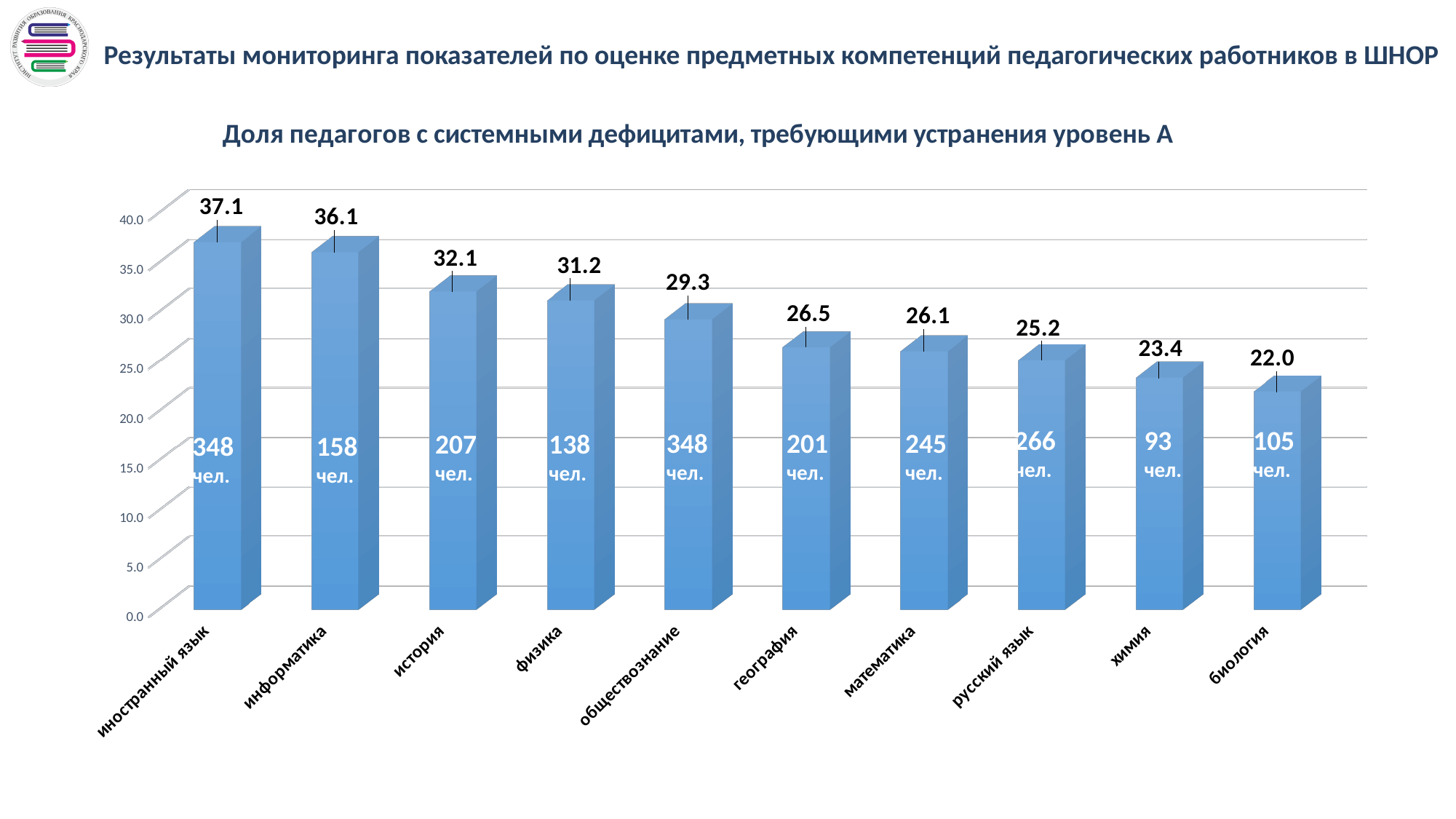
Do the values rise or fall from left to right along the x axis? fall Which is larger, the value for география or the value for русский язык? география What is the difference between the values for иностранный язык and биология? 15.1 What is the value shown for химия? 23.4 Which category has the highest value? иностранный язык How many people (чел.) are shown inside the bar for математика? 245 чел. What is the difference between the values for информатика and физика? 4.9 Is the value for обществознание greater or less than 30.0? less How many categories are shown on the x axis? 10 What kind of chart is shown on the slide? bar chart Which category has the lowest value? биология What is the value shown for история? 32.1